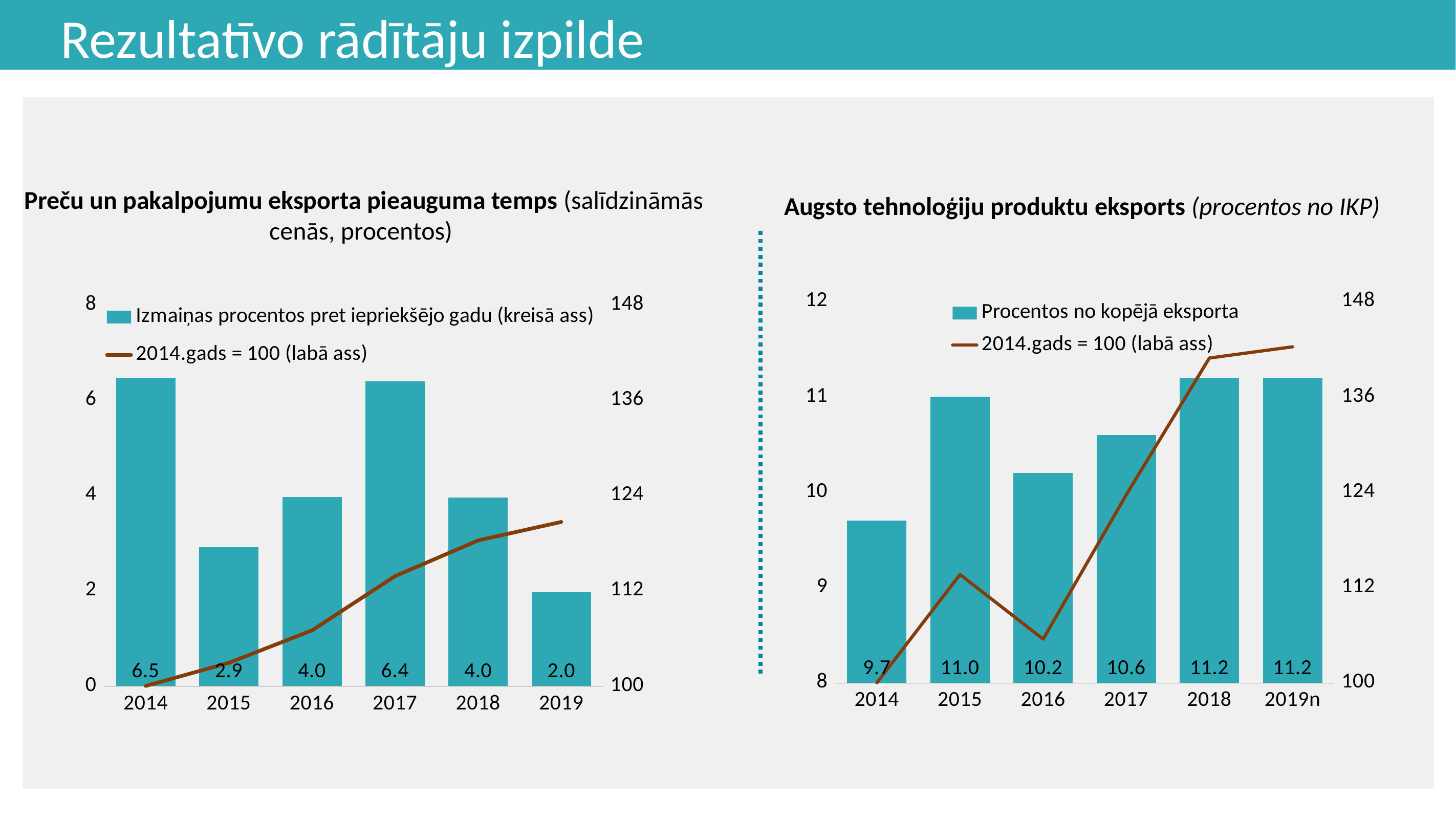
In the right chart (Augsto tehnoloģiju produktu eksports), which year has the lowest bar value? 2014 In the right chart (Augsto tehnoloģiju produktu eksports), what is the value of the bar for 2016? 10.2 In the left chart (Preču un pakalpojumu eksporta pieauguma temps), is the value of the line (2014.gads = 100) for 2019 greater or less than 124? less How many series does the legend of the left chart (Preču un pakalpojumu eksporta pieauguma temps) list? 2 In the left chart (Preču un pakalpojumu eksporta pieauguma temps), which year has the lowest bar value? 2019 In the right chart (Augsto tehnoloģiju produktu eksports), what is the difference between the bar values for 2015 and 2014? 1.3 In the right chart (Augsto tehnoloģiju produktu eksports), does the line series (2014.gads = 100) rise or fall overall from 2014 to 2019n? rise In the left chart (Preču un pakalpojumu eksporta pieauguma temps), what is the value of the bar for 2017? 6.4 In the left chart (Preču un pakalpojumu eksporta pieauguma temps), which bar is larger, 2015 or 2016? 2016 In the left chart (Preču un pakalpojumu eksporta pieauguma temps), what is the difference between the bar values for 2014 and 2019? 4.5 How many years are shown on the x axis of the right chart (Augsto tehnoloģiju produktu eksports)? 6 In the right chart (Augsto tehnoloģiju produktu eksports), is the value of the line (2014.gads = 100) for 2018 greater or less than 136? greater